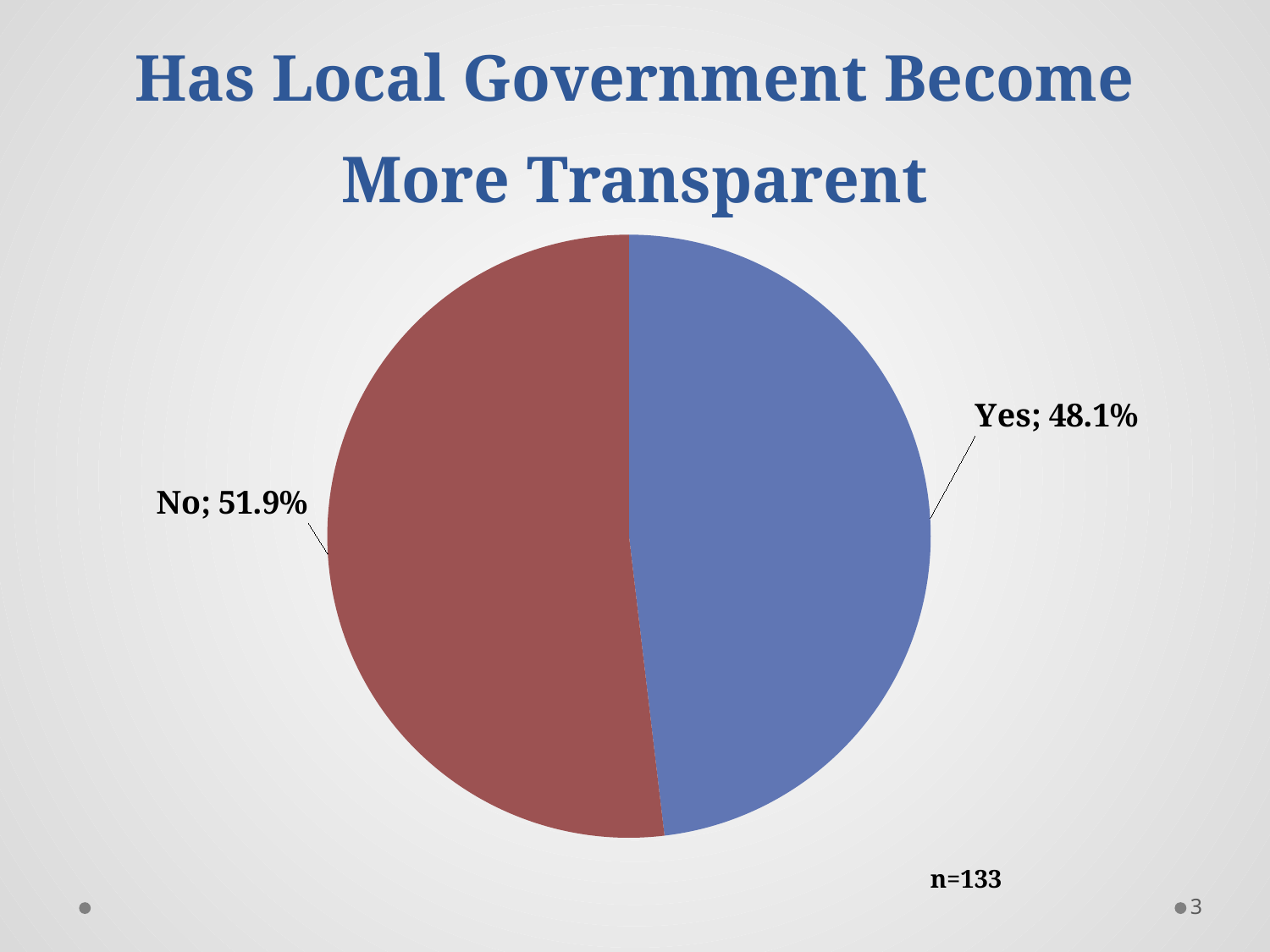
What is the difference in percentage points between the "No" and "Yes" shares? 3.8 What kind of chart is shown on the slide? pie chart How many slices does the pie chart have? 2 Which response has the larger share of the pie? No What percentage of respondents answered "Yes"? 48.1% What is the sample size (n) shown on the slide? 133 Is the share for "No" larger or smaller than the share for "Yes"? larger What share of the pie does the "Yes" slice represent? 48.1% What percentage of respondents answered "No"? 51.9% What is the title of the chart? Has Local Government Become More Transparent Which response has the smaller share of the pie? Yes